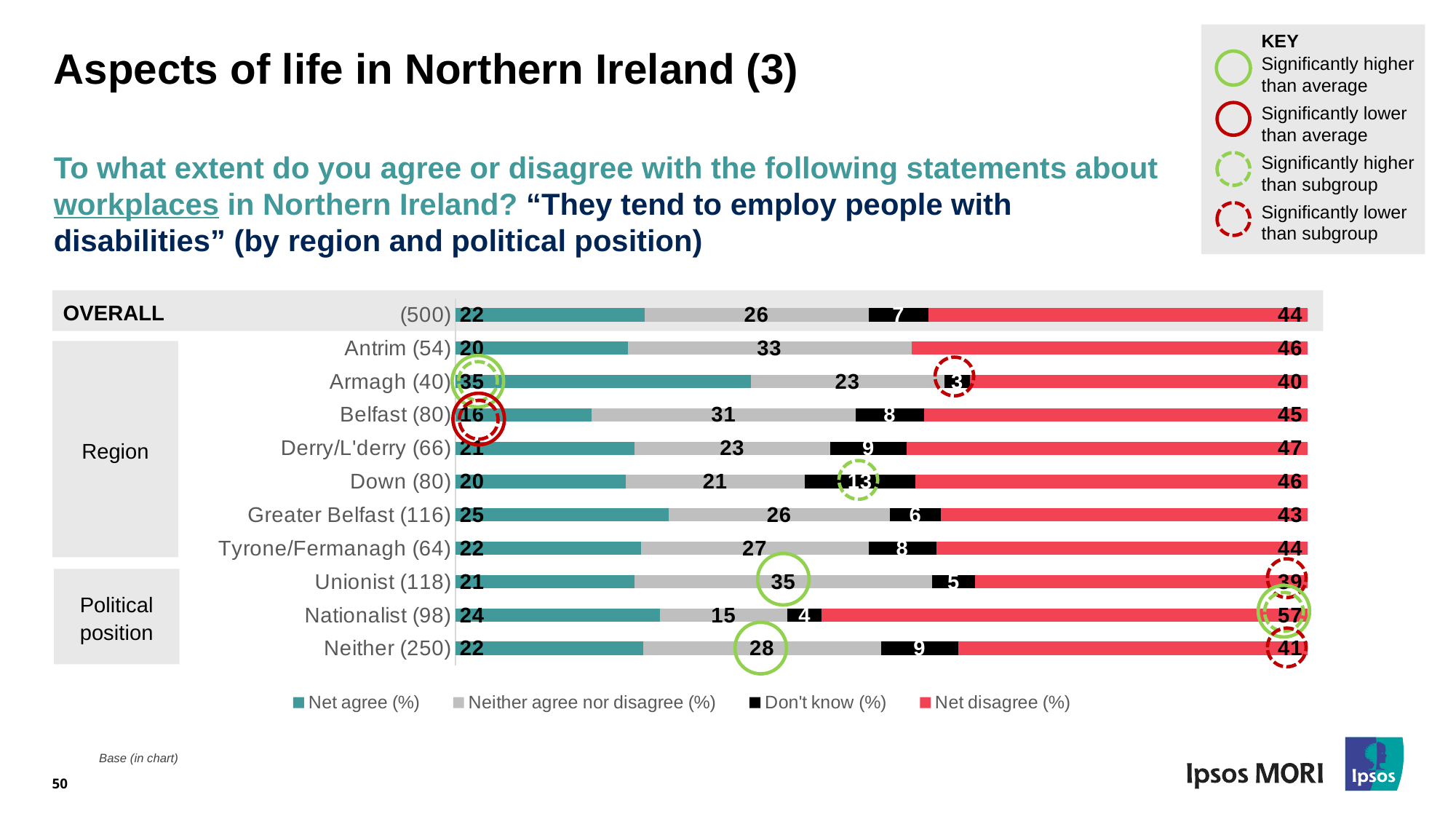
How many series does the legend list? 4 What is the Neither agree nor disagree (%) value for OVERALL (500)? 26 What is the Don't know (%) value for Down (80)? 13 What is the Net disagree (%) value for Nationalist (98)? 57 What is the total of the stacked bar for Belfast (80)? 100 What kind of chart is shown on the slide? Stacked bar chart Which category has the highest Net agree (%) value? Armagh (40) What is the Net agree (%) value for Armagh (40)? 35 Which category has the lowest Net agree (%) value? Belfast (80) Which has a higher Neither agree nor disagree (%) value, Unionist (118) or Nationalist (98)? Unionist (118) What is the difference between the Net disagree (%) values for Nationalist (98) and Unionist (118)? 18 Which category has the lowest Net disagree (%) value? Unionist (118)